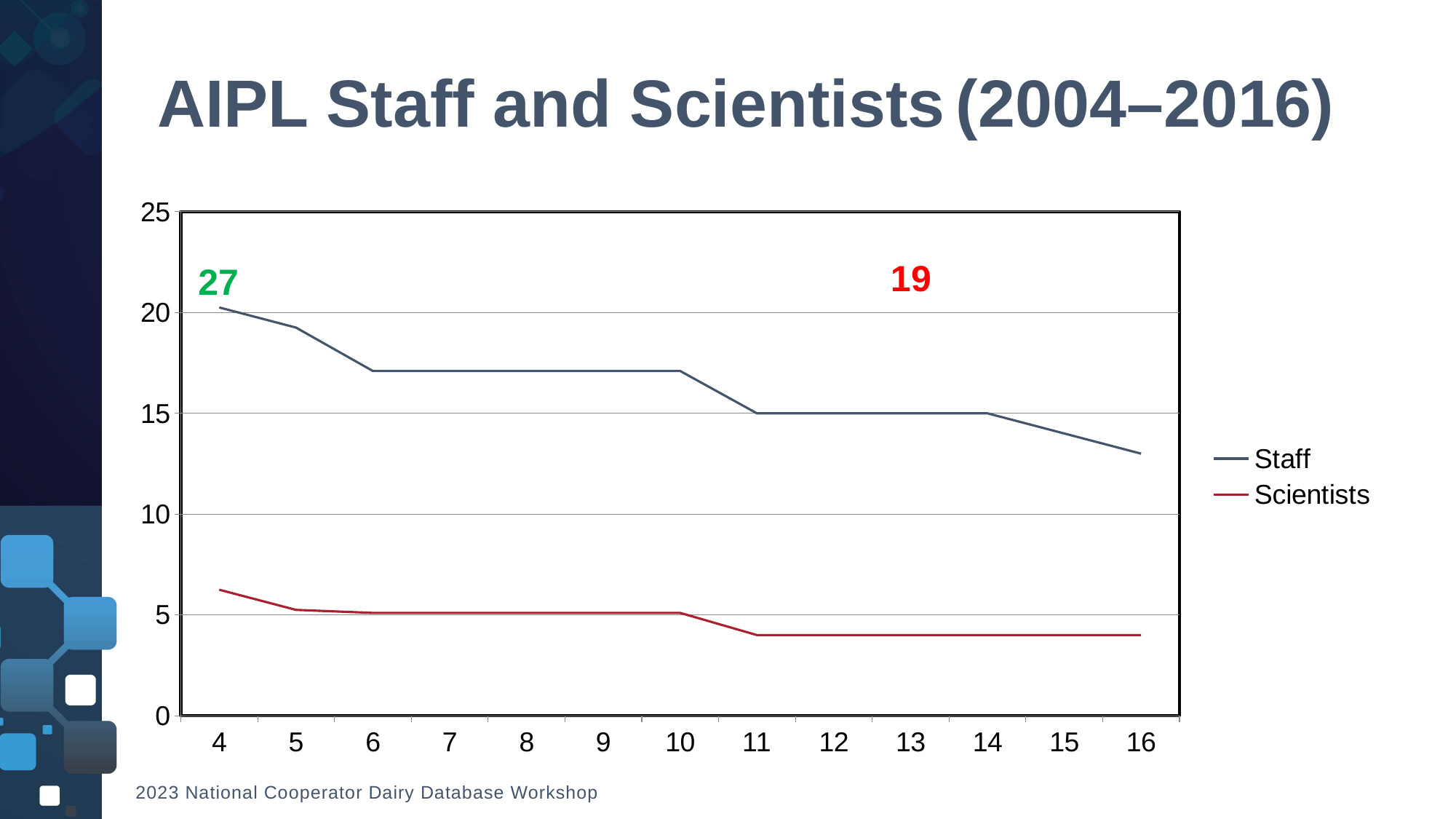
Is the Staff value at x = 16 greater or less than 15? less How many series does the legend list? 2 Does the Staff line rise or fall from 4 to 16 along the x axis? fall Is the Staff value at x = 7 greater or less than 15? greater At which x value is the Staff series lowest? 16 Does the Scientists line rise or fall from 4 to 16 along the x axis? fall At x = 10, which series has the larger value, Staff or Scientists? Staff What is the title of the slide containing the chart? AIPL Staff and Scientists (2004–2016) How many points are plotted along the x axis for each series? 13 At which x value is the Staff series highest? 4 Is the Scientists value at x = 14 greater or less than 5? less What kind of chart is shown on the slide? line chart